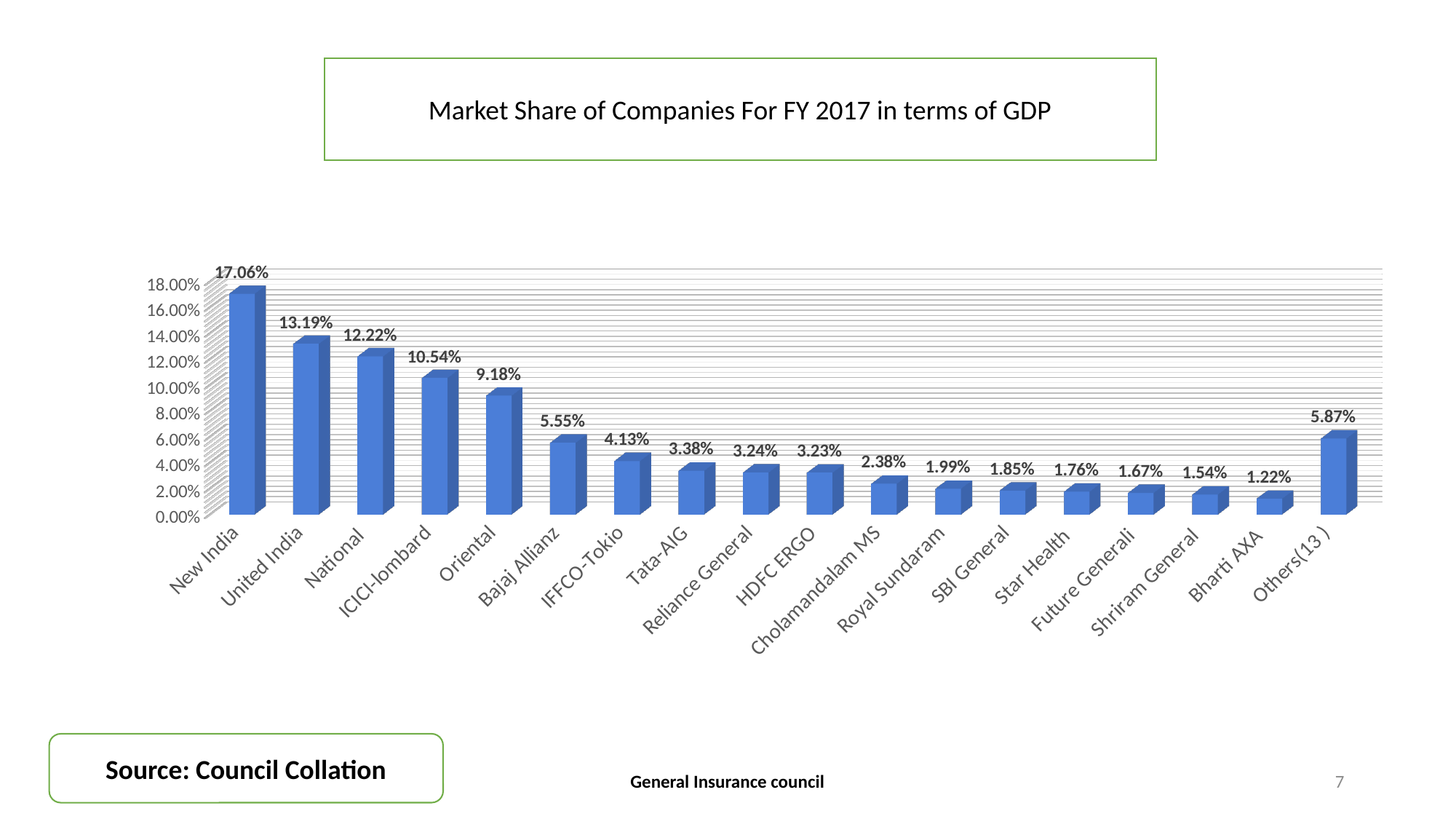
Which company has the lowest market share? Bharti AXA Which company has the highest market share? New India What is the market share of Cholamandalam MS? 2.38% What is the title of the chart? Market Share of Companies For FY 2017 in terms of GDP What is the market share shown for Others(13)? 5.87% Which has a larger market share, Oriental or Bajaj Allianz? Oriental What is the difference in market share between New India and United India? 3.87% What type of chart is shown on the slide? Bar chart What is the market share of New India? 17.06% How many companies/categories are shown on the chart? 18 What is the difference in market share between Others(13) and Bajaj Allianz? 0.32% What is the market share of ICICI-lombard? 10.54%